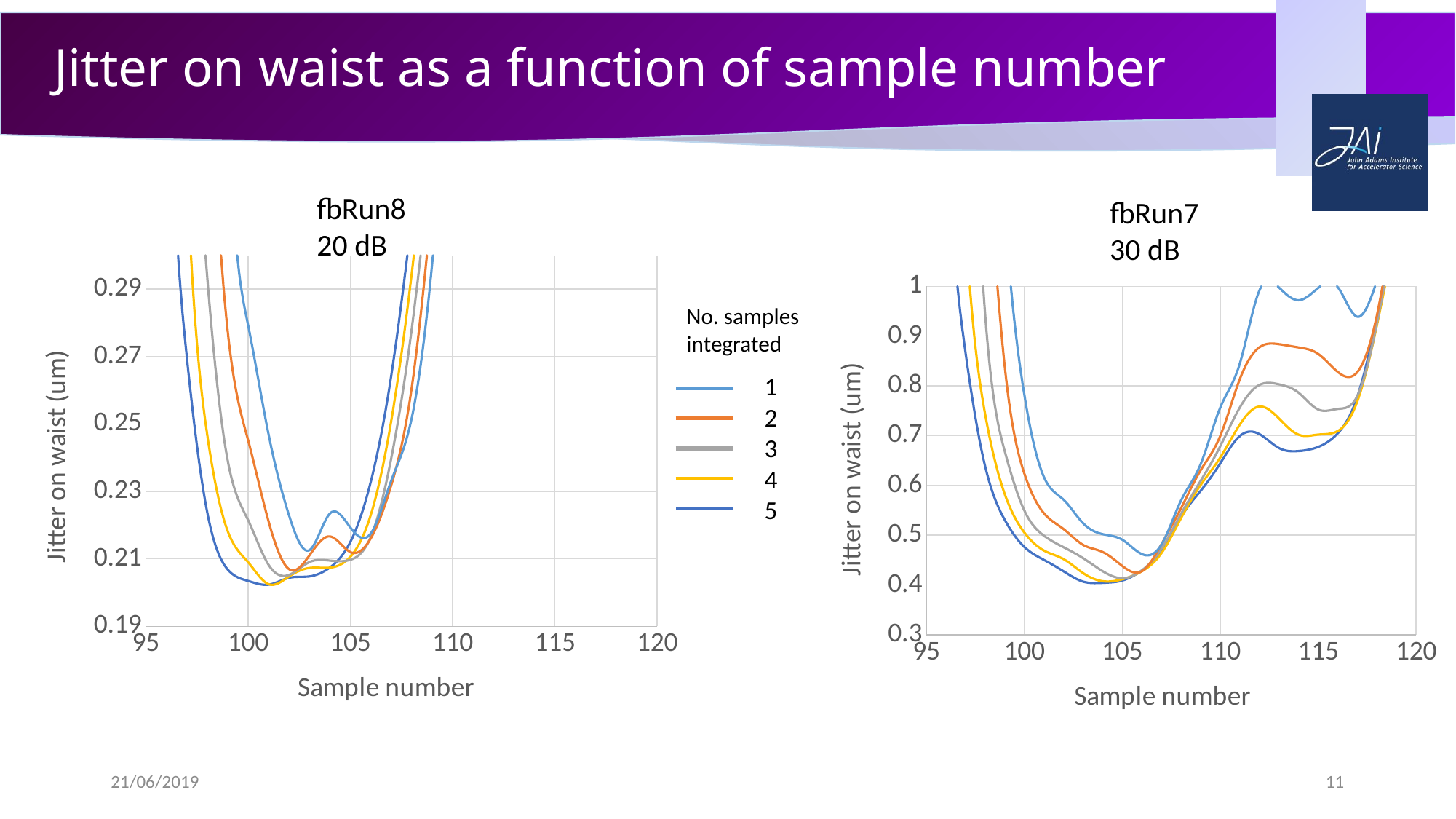
In the fbRun7 30 dB chart, is the value of series 5 at sample number 115 greater or less than 0.7? less What is the x-axis title of the fbRun7 30 dB chart on the right? Sample number In the fbRun7 30 dB chart, does series 5 rise or fall between sample number 105 and sample number 110? rise In the fbRun7 30 dB chart, is the value of series 1 at sample number 115 greater or less than 0.9? greater In the fbRun7 30 dB chart, is the value of series 2 at sample number 112 greater or less than 0.8? greater What is the title of the legend shared by the two charts? No. samples integrated How many series does the legend list for the charts on the slide? 5 In the fbRun7 30 dB chart, which series has the larger value at sample number 115, series 1 or series 5? series 1 What kind of chart is the fbRun8 20 dB chart on the left? line chart In the fbRun8 20 dB chart, which series has the larger value at sample number 104, series 1 or series 5? series 1